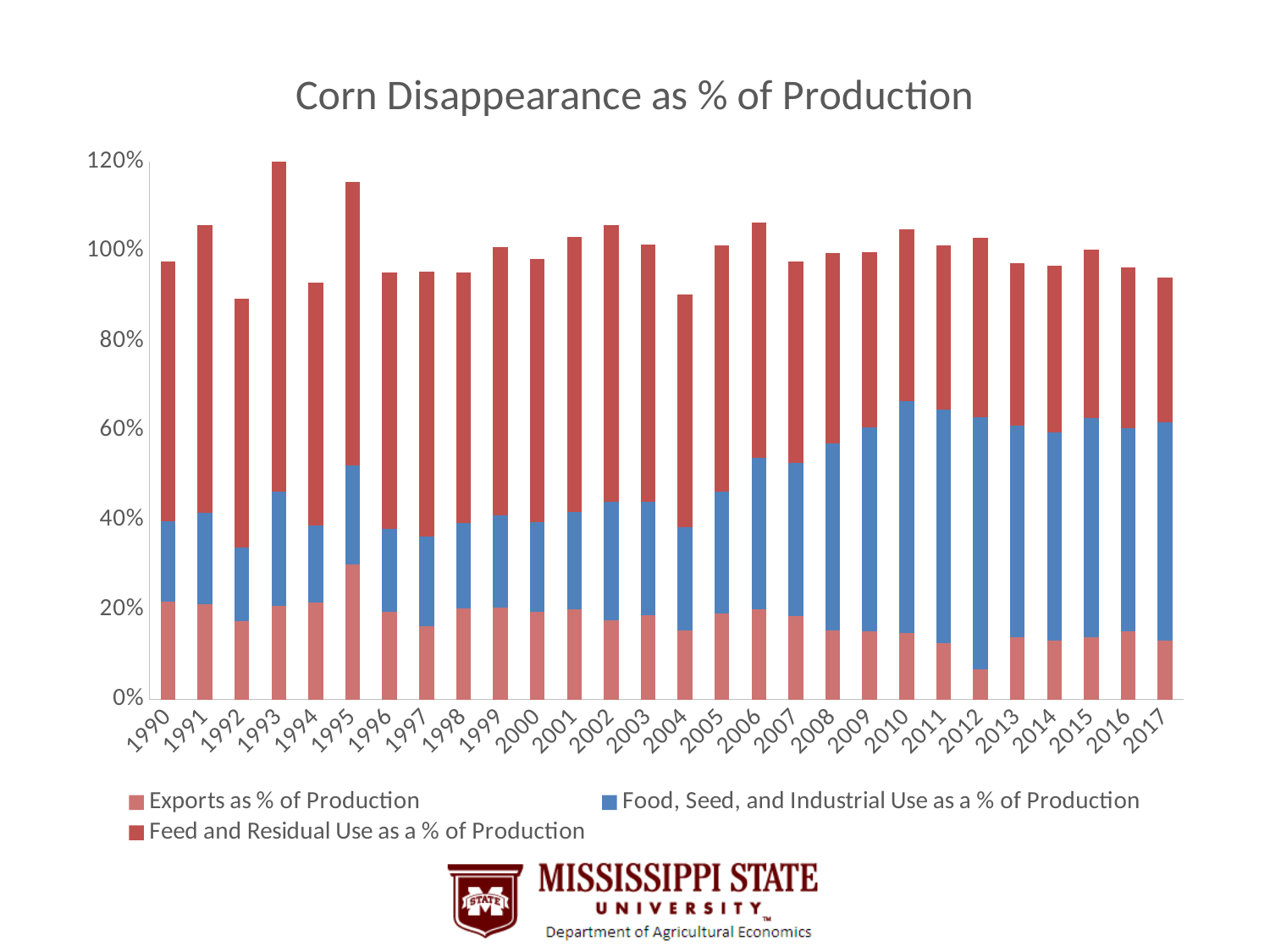
Which year has the smallest Exports as % of Production segment? 2012 What kind of chart is shown on the slide? Stacked bar chart Which year has the tallest total bar? 1993 How many years are shown on the x axis? 28 Is the Exports as % of Production segment for 2012 greater or less than 20%? less What is the title of the chart? Corn Disappearance as % of Production Which year has the taller total bar, 1993 or 1995? 1993 Is the total bar for 1993 greater or less than 100%? greater Is the total bar for 1992 greater or less than 100%? less Which colour represents Feed and Residual Use as a % of Production in the legend? Dark red Which year has the largest Exports as % of Production segment? 1995 How many series does the legend list? 3